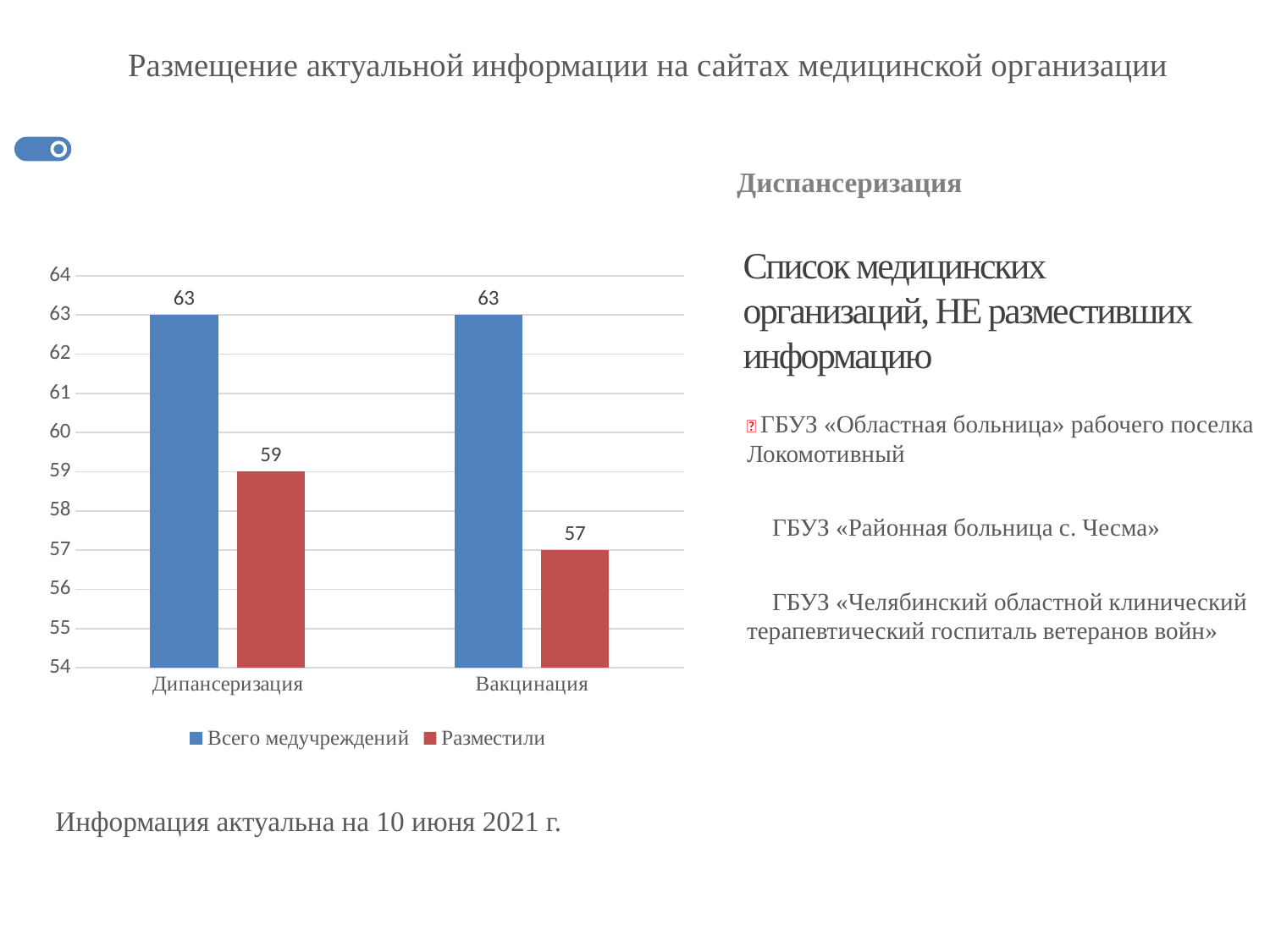
Which category has the lowest value for 'Разместили'? Вакцинация How many series does the legend list? 2 What is the value of 'Разместили' for 'Вакцинация'? 57 What is the difference between 'Всего медучреждений' and 'Разместили' for 'Вакцинация'? 6 What is the difference between 'Всего медучреждений' and 'Разместили' for 'Дипансеризация'? 4 Which is larger: 'Разместили' for 'Дипансеризация' or 'Разместили' for 'Вакцинация'? Дипансеризация What is the value of 'Всего медучреждений' for 'Дипансеризация'? 63 What kind of chart is shown on the slide? bar chart How many categories are shown on the x axis? 2 What is the value of 'Разместили' for 'Дипансеризация'? 59 Which colour represents the 'Разместили' series? red What is the value of 'Всего медучреждений' for 'Вакцинация'? 63